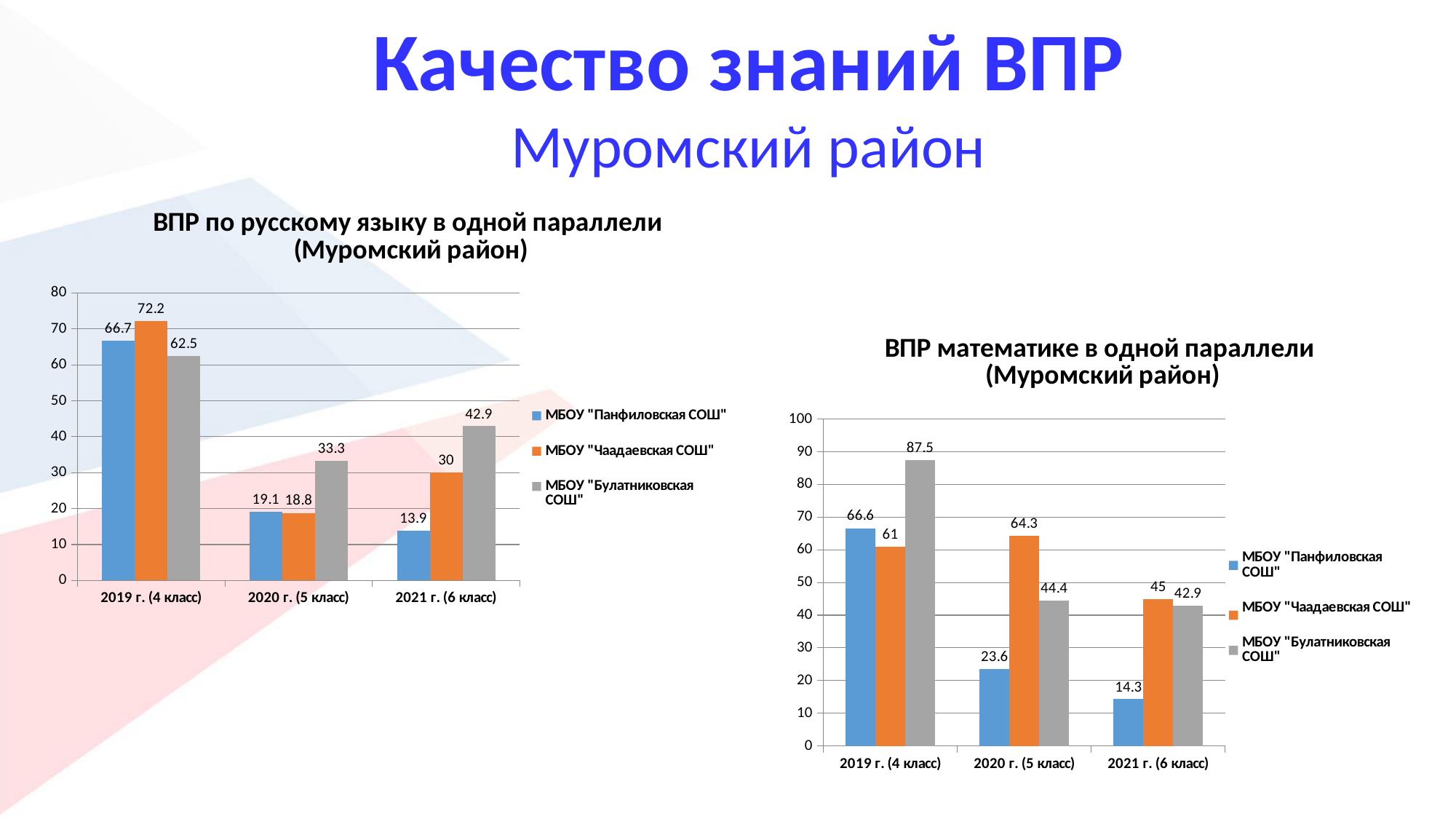
In the chart 'ВПР по русскому языку в одной параллели (Муромский район)', what is the value for МБОУ "Чаадаевская СОШ" in 2019 г. (4 класс)? 72.2 In the chart 'ВПР по русскому языку в одной параллели (Муромский район)', which school has the lowest value in 2021 г. (6 класс)? МБОУ "Панфиловская СОШ" What type of chart is 'ВПР по русскому языку в одной параллели (Муромский район)'? Bar chart In the chart 'ВПР по русскому языку в одной параллели (Муромский район)', what is the difference between МБОУ "Булатниковская СОШ" and МБОУ "Панфиловская СОШ" in 2020 г. (5 класс)? 14.2 In the chart 'ВПР по русскому языку в одной параллели (Муромский район)', what is the value for МБОУ "Булатниковская СОШ" in 2021 г. (6 класс)? 42.9 In the chart 'ВПР математике в одной параллели (Муромский район)', what is the value for МБОУ "Булатниковская СОШ" in 2019 г. (4 класс)? 87.5 In the chart 'ВПР математике в одной параллели (Муромский район)', which school has the highest value in 2020 г. (5 класс)? МБОУ "Чаадаевская СОШ" In the chart 'ВПР математике в одной параллели (Муромский район)', what is the value for МБОУ "Панфиловская СОШ" in 2020 г. (5 класс)? 23.6 In the chart 'ВПР по русскому языку в одной параллели (Муромский район)', how does the value for МБОУ "Панфиловская СОШ" change from 2019 to 2021? It falls In the chart 'ВПР математике в одной параллели (Муромский район)', what is the difference between МБОУ "Чаадаевская СОШ" and МБОУ "Панфиловская СОШ" in 2021 г. (6 класс)? 30.7 In the chart 'ВПР математике в одной параллели (Муромский район)', which is larger in 2019 г. (4 класс): МБОУ "Панфиловская СОШ" or МБОУ "Чаадаевская СОШ"? МБОУ "Панфиловская СОШ" How many series does the legend of the chart 'ВПР математике в одной параллели (Муромский район)' list? 3